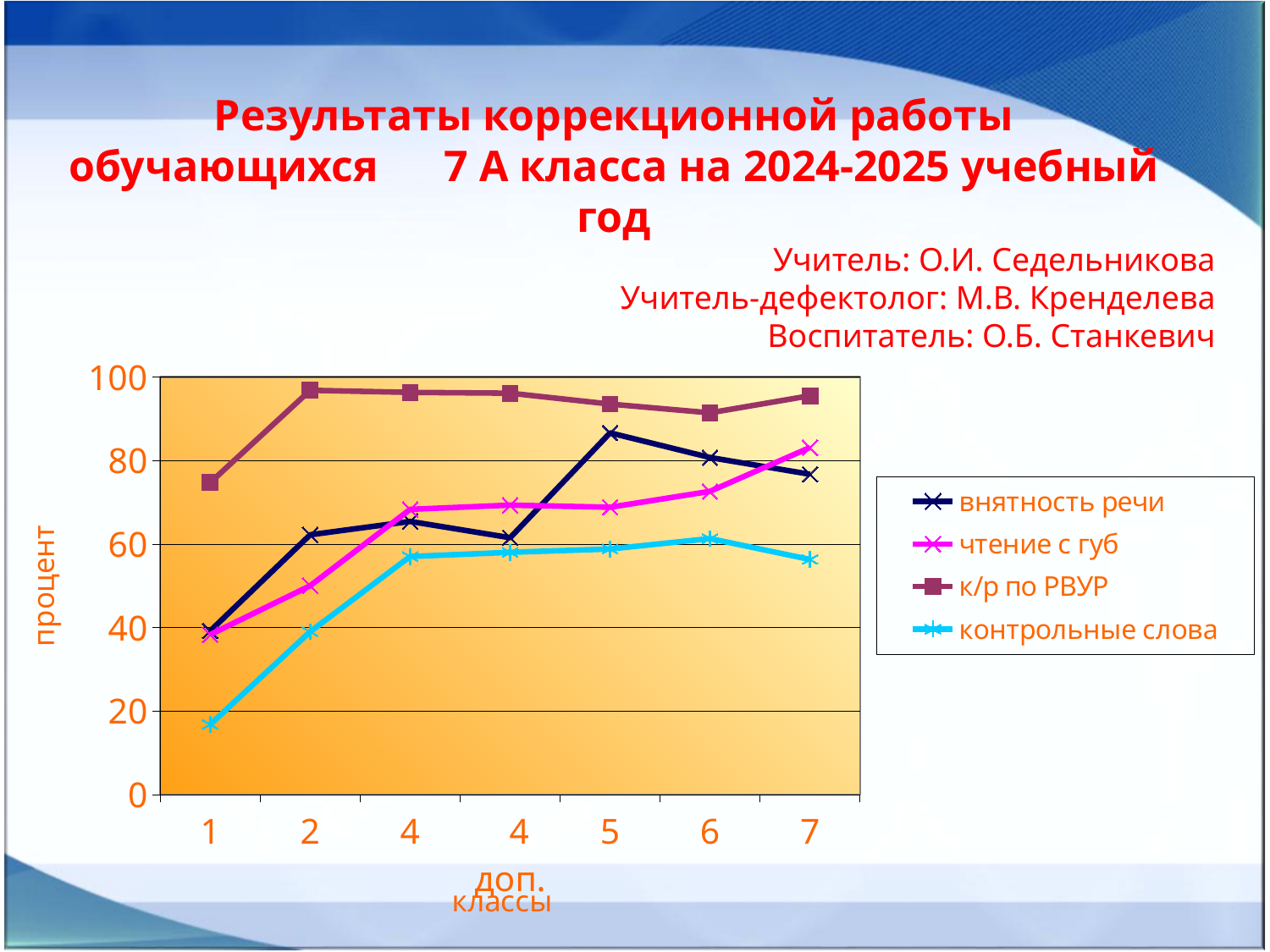
Which series has the highest value at category 1? к/р по РВУР Does the value for контрольные слова rise or fall from category 1 to category 2? rise At category 5, which is larger: внятность речи or чтение с губ? внятность речи Which series has the lowest value at category 1? контрольные слова Is the value for к/р по РВУР at category 2 greater or less than 80? greater Is the value for внятность речи at category 5 greater or less than 80? greater Is the value for контрольные слова at category 7 greater or less than 60? less What is the title of the vertical axis? процент How many series does the legend list? 4 What kind of chart is shown on the slide? line chart How many categories are shown along the x axis? 7